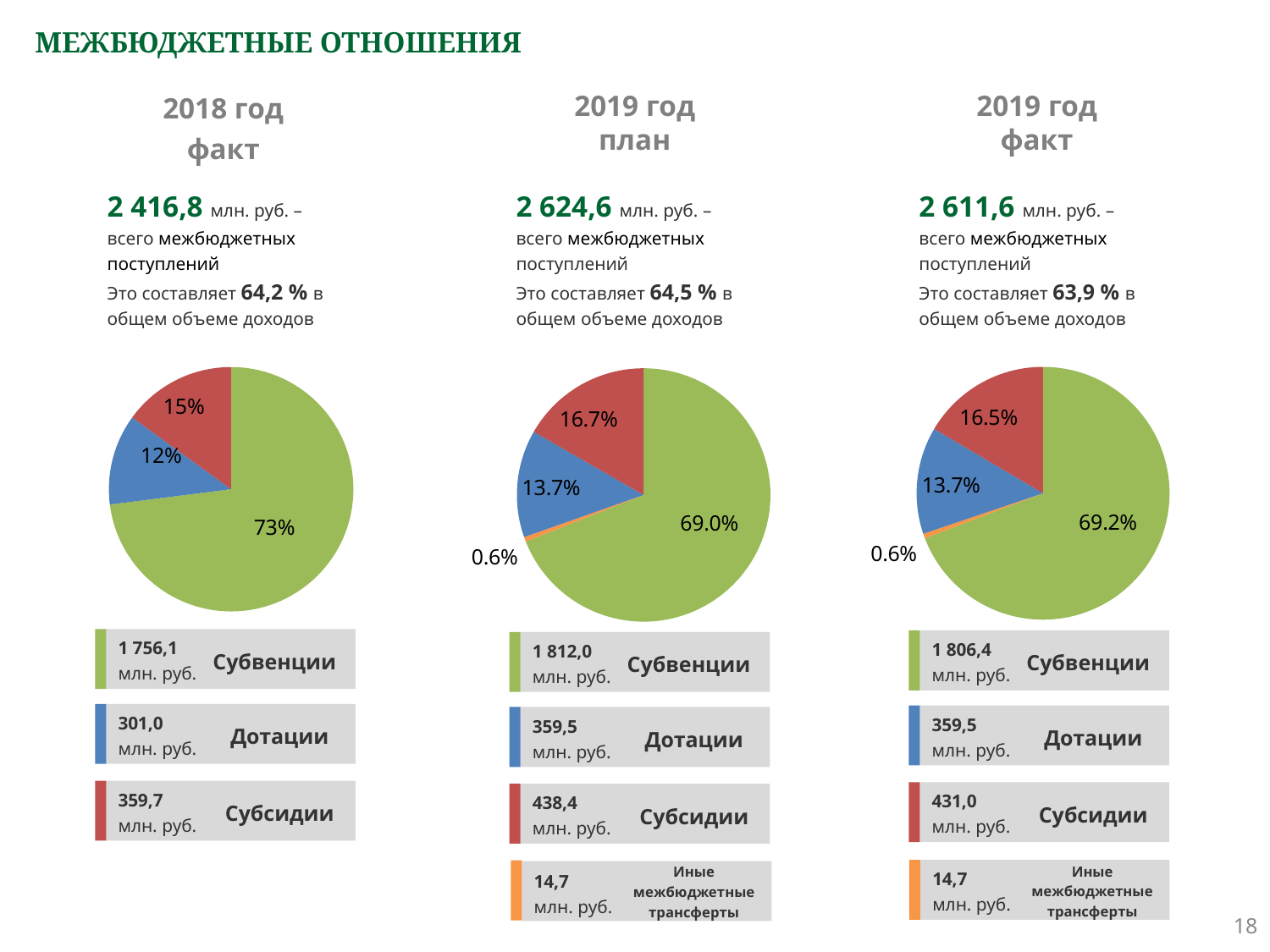
In the 2019 год план pie chart, what percentage is shown for the Дотации (blue) slice? 13.7% How many slices does the 2019 год план pie chart have? 4 In the 2018 год факт pie chart, what percentage share is shown for the largest slice (Субвенции)? 73% How many slices does the 2018 год факт pie chart have? 3 In the 2019 год план chart legend, what value in млн. руб. is given for Субсидии? 438,4 In the 2019 год план chart, which category has the largest share? Субвенции In the 2018 год факт chart, which category has the smallest share? Дотации In the 2019 год факт pie chart, what percentage is shown for the Иные межбюджетные трансферты (orange) slice? 0.6% What type of chart is used for the 2019 год факт data? pie chart In the 2019 год план chart, what is the difference in percentage points between the Субвенции slice (69.0%) and the Субсидии slice (16.7%)? 52.3 Which is larger in the 2019 год факт chart: the Субсидии slice or the Дотации slice? Субсидии